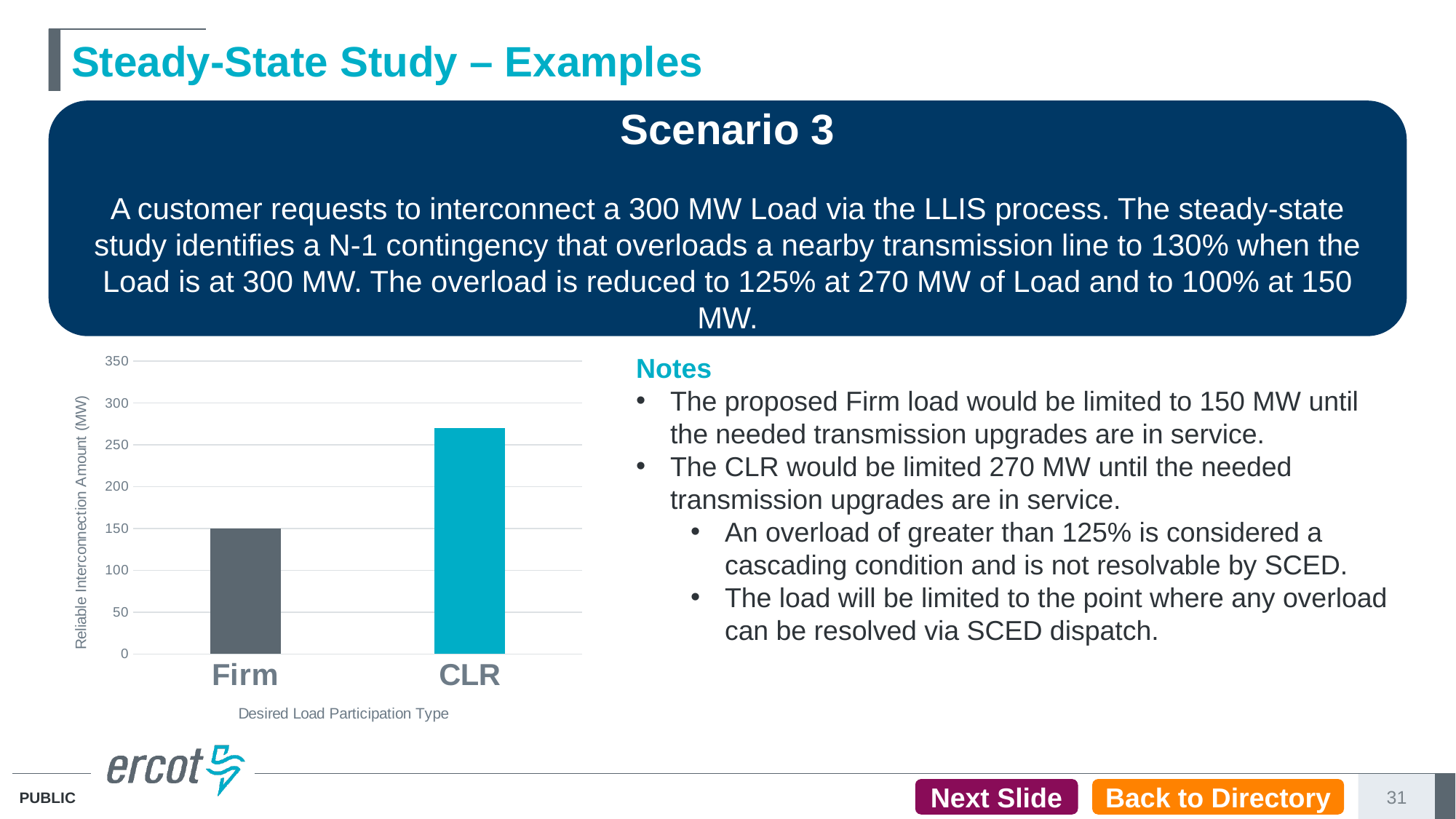
How many categories are plotted on the x axis of the chart? 2 What is the title of the chart's y axis? Reliable Interconnection Amount (MW) Which has a larger Reliable Interconnection Amount, Firm or CLR? CLR What is the Reliable Interconnection Amount (MW) for Firm? 150 Which category has the lowest Reliable Interconnection Amount? Firm Is the value for Firm greater or less than 200? less What kind of chart is shown on the slide? bar chart Is the value for CLR greater or less than 300? less Is the value for CLR greater or less than 250? greater Which category has the highest Reliable Interconnection Amount? CLR What is the title of the chart's x axis? Desired Load Participation Type